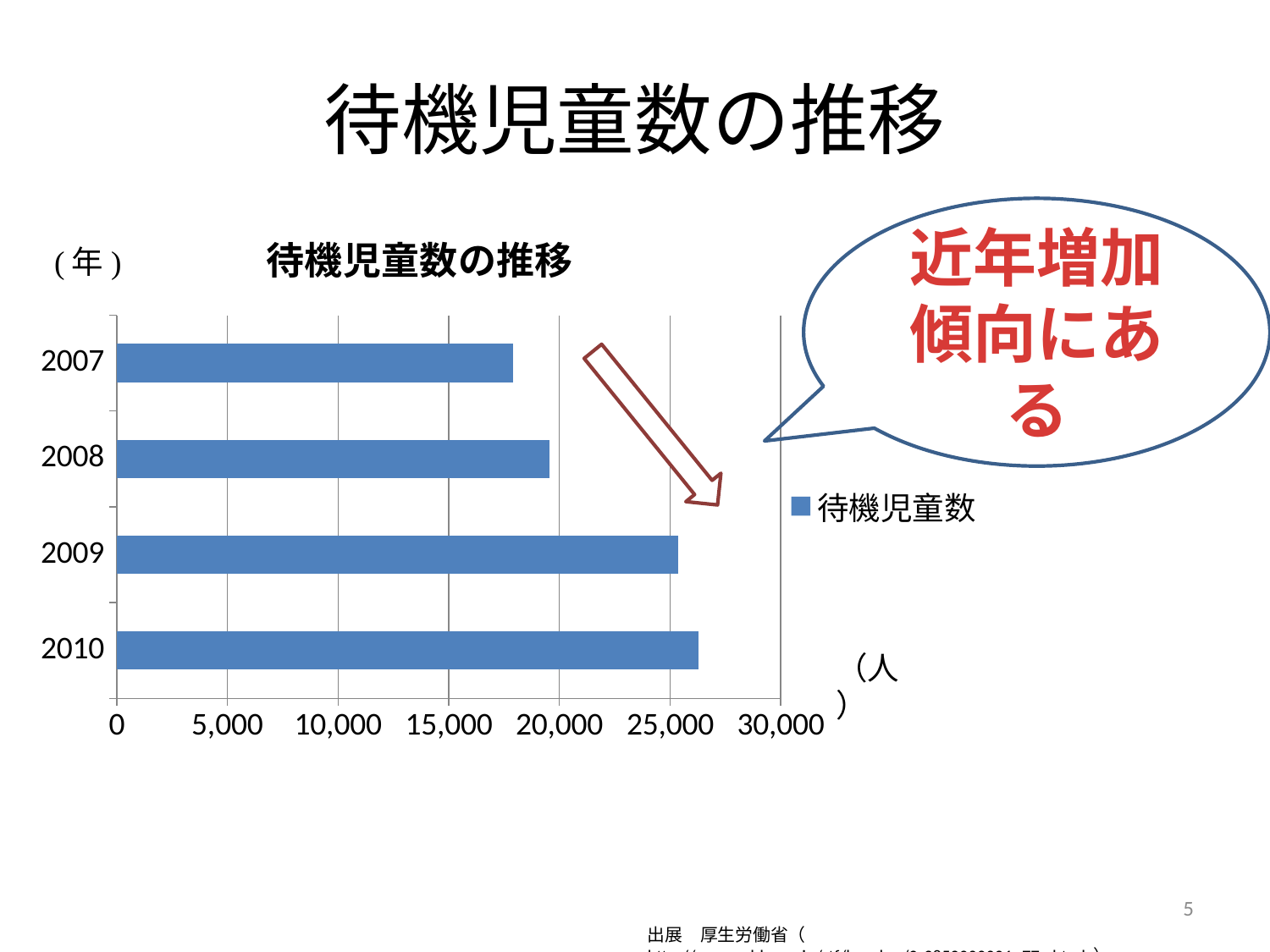
What kind of chart is shown on the slide? bar chart How many series does the chart legend list? 1 Which is larger, the value for 2009 or the value for 2007? 2009 What is the title of the chart? 待機児童数の推移 What series name is shown in the chart legend? 待機児童数 Which is larger, the value for 2010 or the value for 2008? 2010 How many years (categories) are plotted in the chart? 4 Do the values rise or fall from 2007 to 2010? rise Is the value for 2008 greater or less than 15,000? greater Is the value for 2007 greater or less than 20,000? less Which year has the lowest value in the chart? 2007